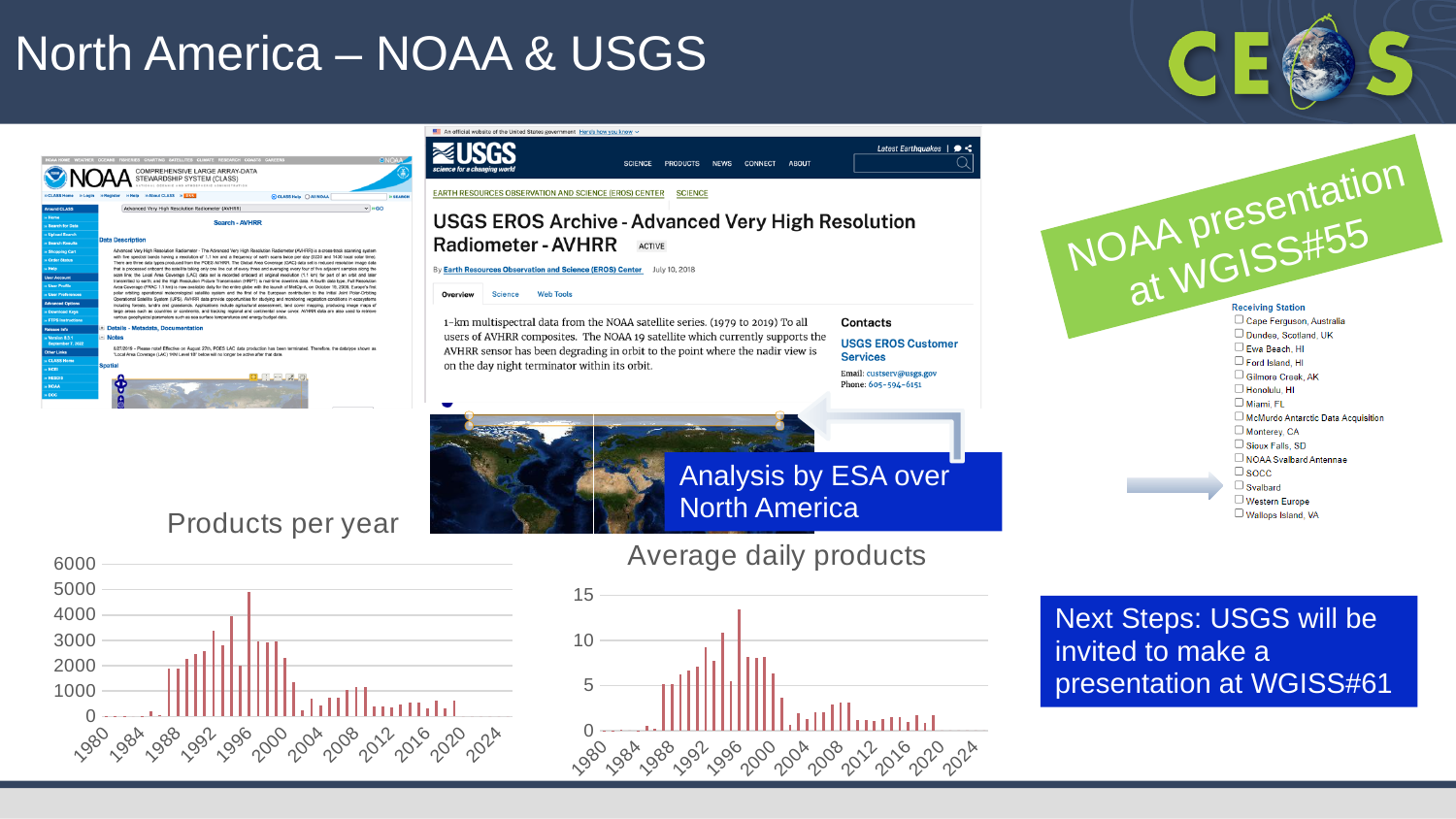
In the 'Average daily products' chart, do the values generally rise or fall from 1984 to 1996? rise What kind of chart is the 'Average daily products' chart? bar chart What kind of chart is the 'Products per year' chart? bar chart In the 'Average daily products' chart, which is larger, the value for 2000 or the value for 2020? 2000 In the 'Products per year' chart, is the value of the tallest bar greater or less than 4000? greater In the 'Products per year' chart, which is larger, the value for 1992 or the value for 2012? 1992 In the 'Products per year' chart, is the value for 2020 greater or less than 1000? less What is the highest tick value on the y axis of the 'Products per year' chart? 6000 In the 'Products per year' chart, do the values generally rise or fall from 1996 to 2024? fall What is the title of the chart in the middle of the slide? Average daily products In the 'Average daily products' chart, is the value of the tallest bar greater or less than 10? greater